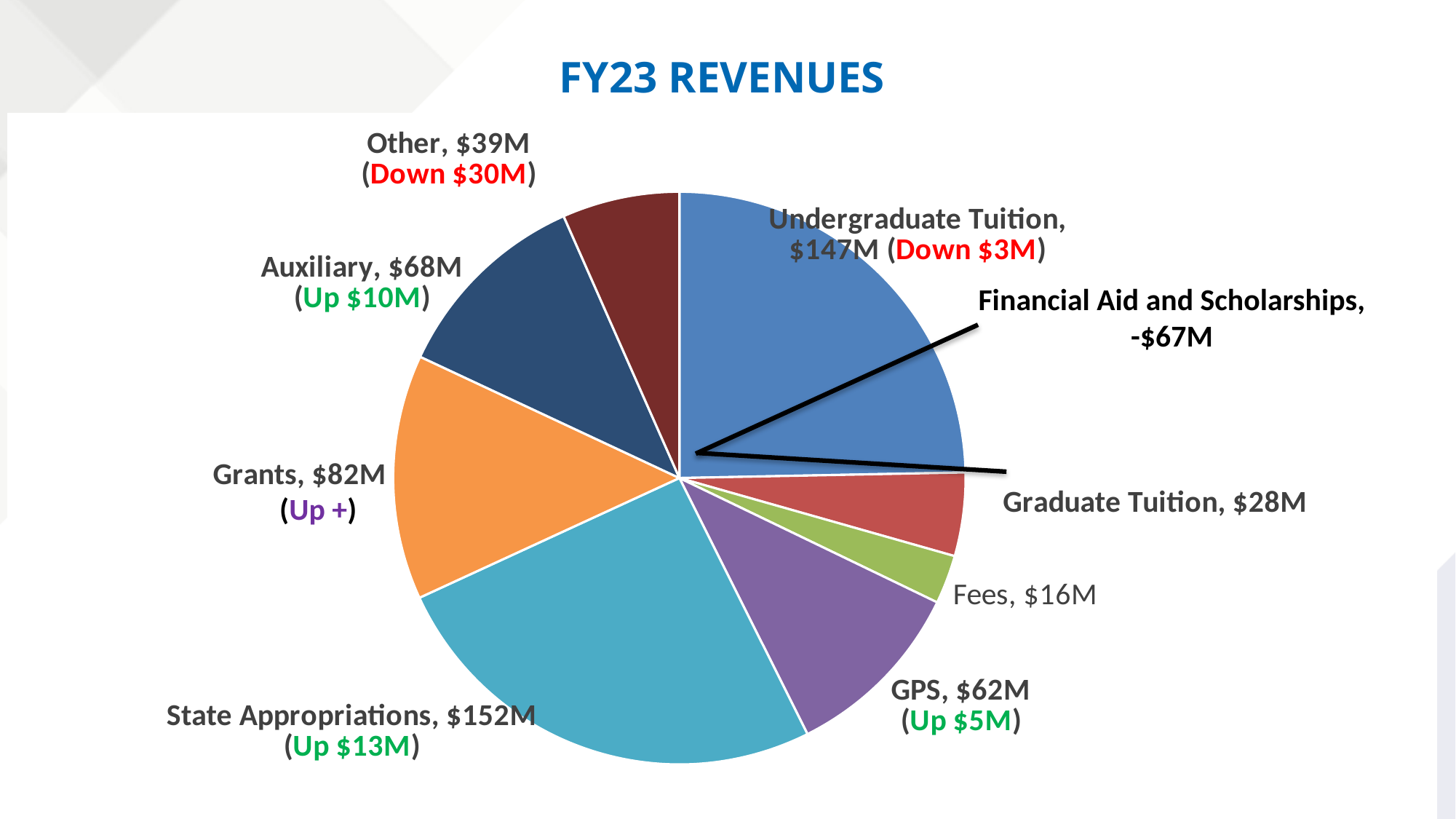
By how much did the Other revenue category change according to the label? Down $30M How many revenue categories (slices) are shown in the pie chart? 8 Which is larger, the GPS revenue or the Graduate Tuition revenue? GPS Which revenue category has the smallest slice of the pie? Fees What is the difference between State Appropriations revenue and Undergraduate Tuition revenue? $5M Which revenue category has the largest slice of the pie? State Appropriations What type of chart is shown on the slide? Pie chart What is the FY23 revenue value for Undergraduate Tuition? $147M What is the FY23 revenue value for State Appropriations? $152M What is the title of the chart? FY23 REVENUES What is the difference between the Grants revenue and the Auxiliary revenue? $14M What is the FY23 revenue value for Fees? $16M